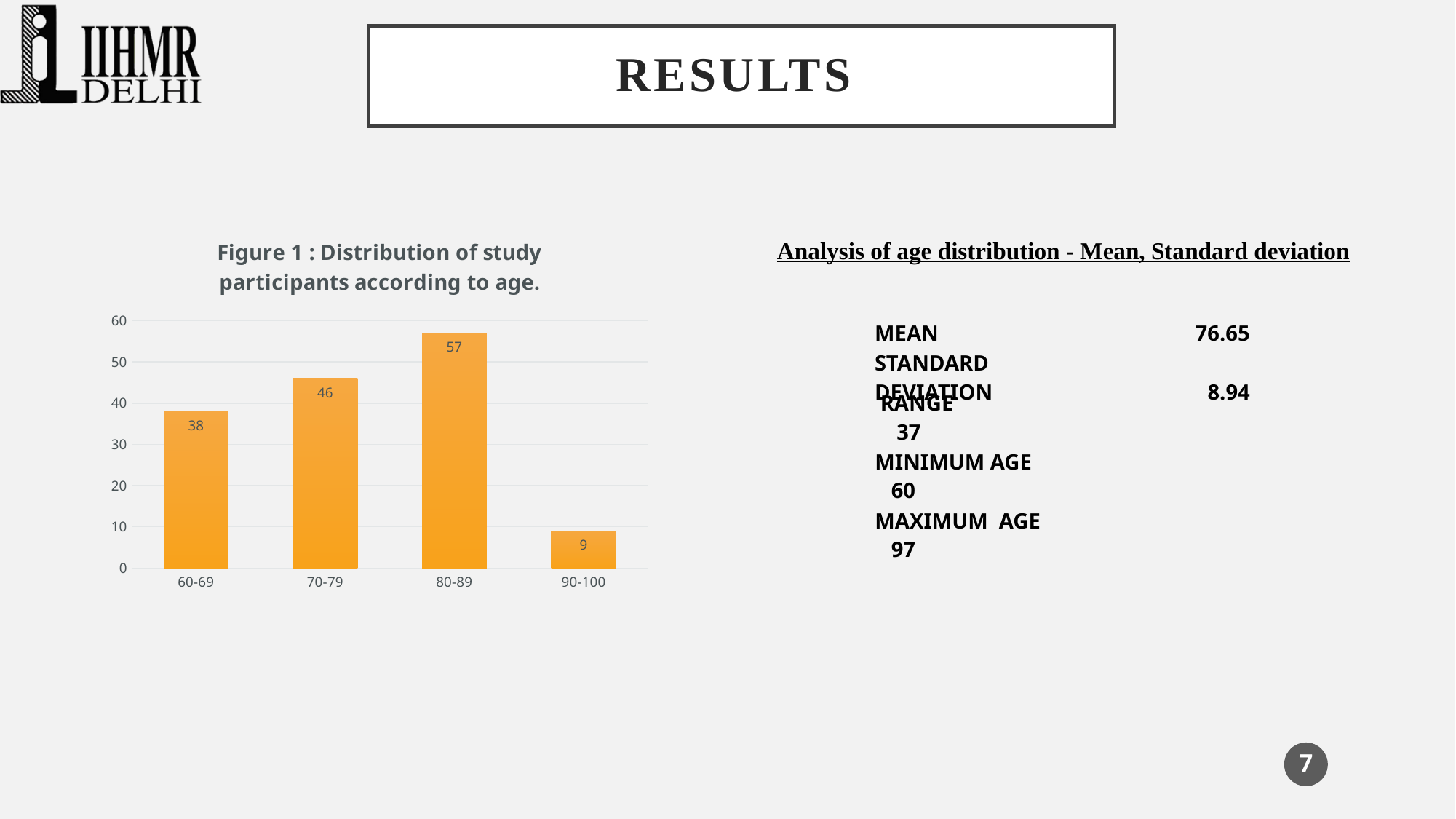
Which age group has the highest number of participants? 80-89 What is the value for the 90-100 age group? 9 How many age groups are shown on the x axis? 4 Which is larger, the value for 60-69 or the value for 70-79? 70-79 Which age group has the lowest number of participants? 90-100 What is the value for the 80-89 age group? 57 What is the value for the 70-79 age group? 46 What is the difference between the values for the 80-89 and 70-79 age groups? 11 What colour are the bars in the chart? Orange What is the value for the 60-69 age group? 38 What kind of chart is shown on the slide? Bar chart What is the title of the chart? Figure 1 : Distribution of study participants according to age.